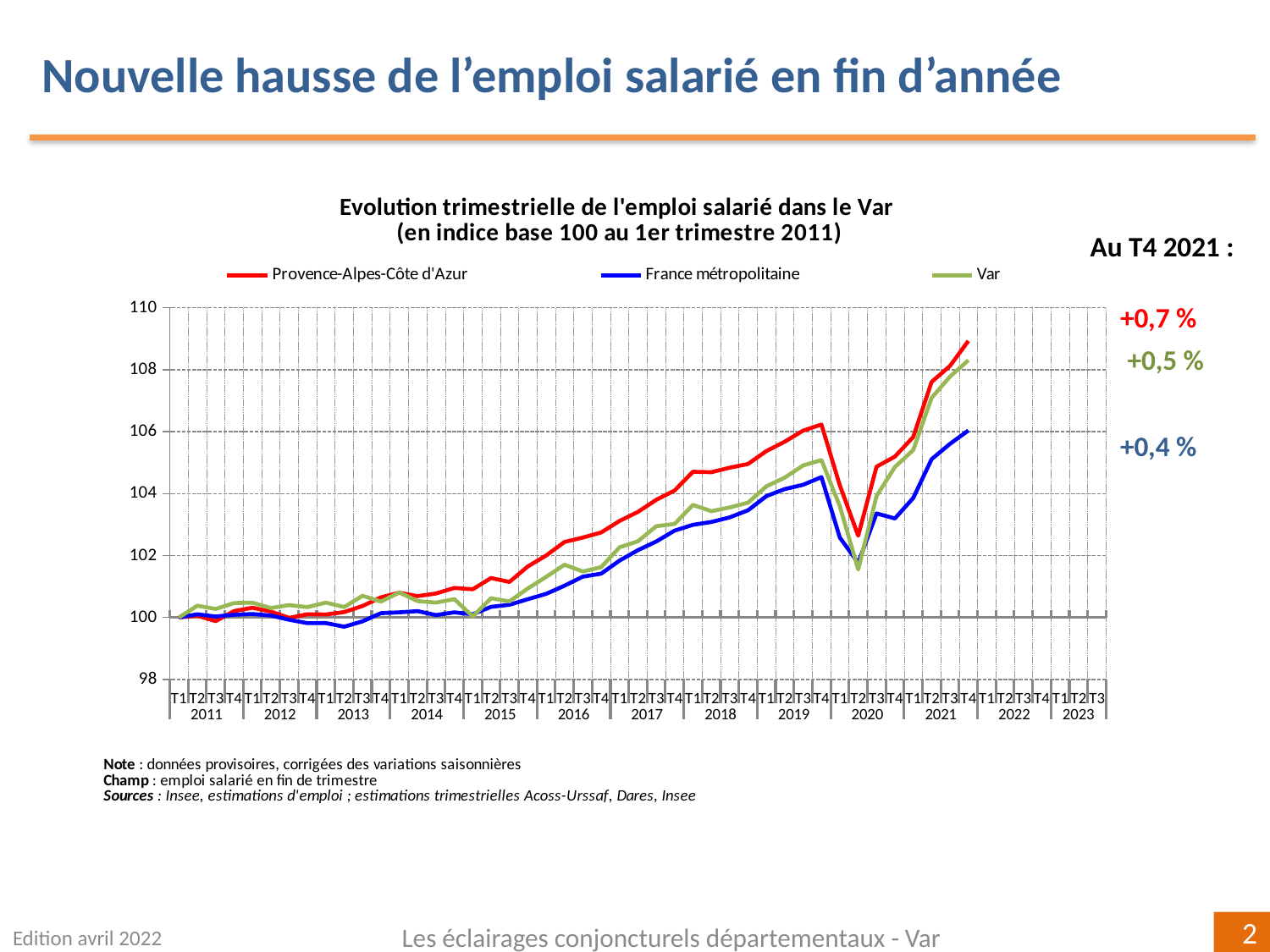
What quarterly change is shown for the Var at T4 2021? +0,5 % What quarterly change is shown for France métropolitaine at T4 2021? +0,4 % How many series does the legend list? 3 What is the title of the chart? Evolution trimestrielle de l'emploi salarié dans le Var (en indice base 100 au 1er trimestre 2011) Which series has the highest index value at T4 2021? Provence-Alpes-Côte d'Azur What quarterly change is shown for Provence-Alpes-Côte d'Azur at T4 2021? +0,7 % Which series has the lowest index value at T4 2021? France métropolitaine Which series is drawn in red? Provence-Alpes-Côte d'Azur What is the index value of all three series at T1 2011? 100 Overall, do the index values rise or fall from 2011 to 2021? rise Is the value for Provence-Alpes-Côte d'Azur at T4 2021 greater or less than 108? greater What kind of chart is shown on the slide? line chart